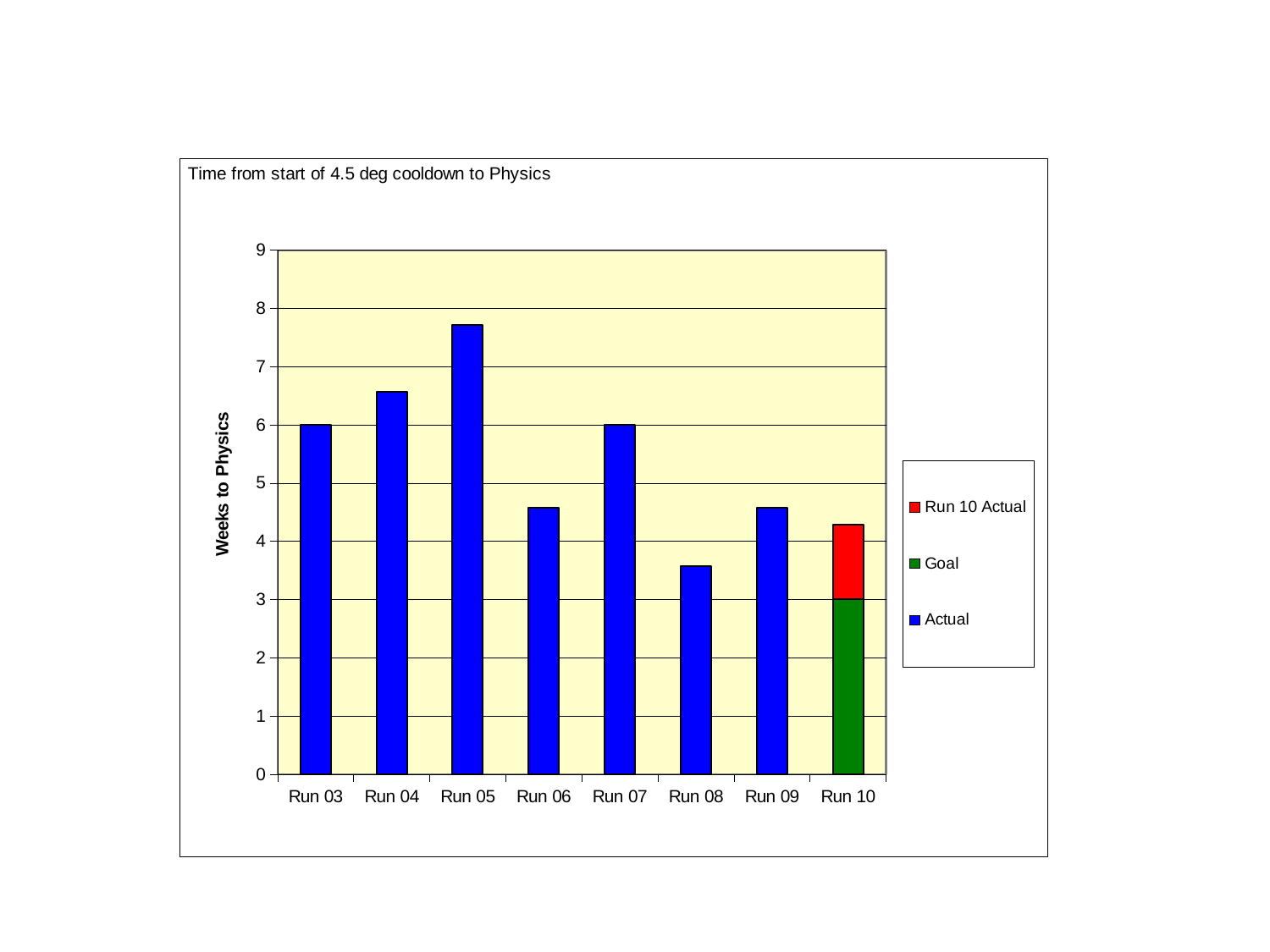
Which run has the highest number of weeks to Physics? Run 05 Is the value for Run 08 greater or less than 4? less Which is larger, the value for Run 04 or the value for Run 06? Run 04 What colour represents the Goal series in the chart? green What type of chart is shown on the slide? bar chart What is the title of the chart? Time from start of 4.5 deg cooldown to Physics Is the value for Run 04 greater or less than 6? greater What is the Goal value for Run 10, in weeks to Physics? 3 Which run has the lowest number of weeks to Physics? Run 08 How many series does the chart legend list? 3 How many runs are shown along the x axis of the chart? 8 Is the value for Run 05 greater or less than 7? greater